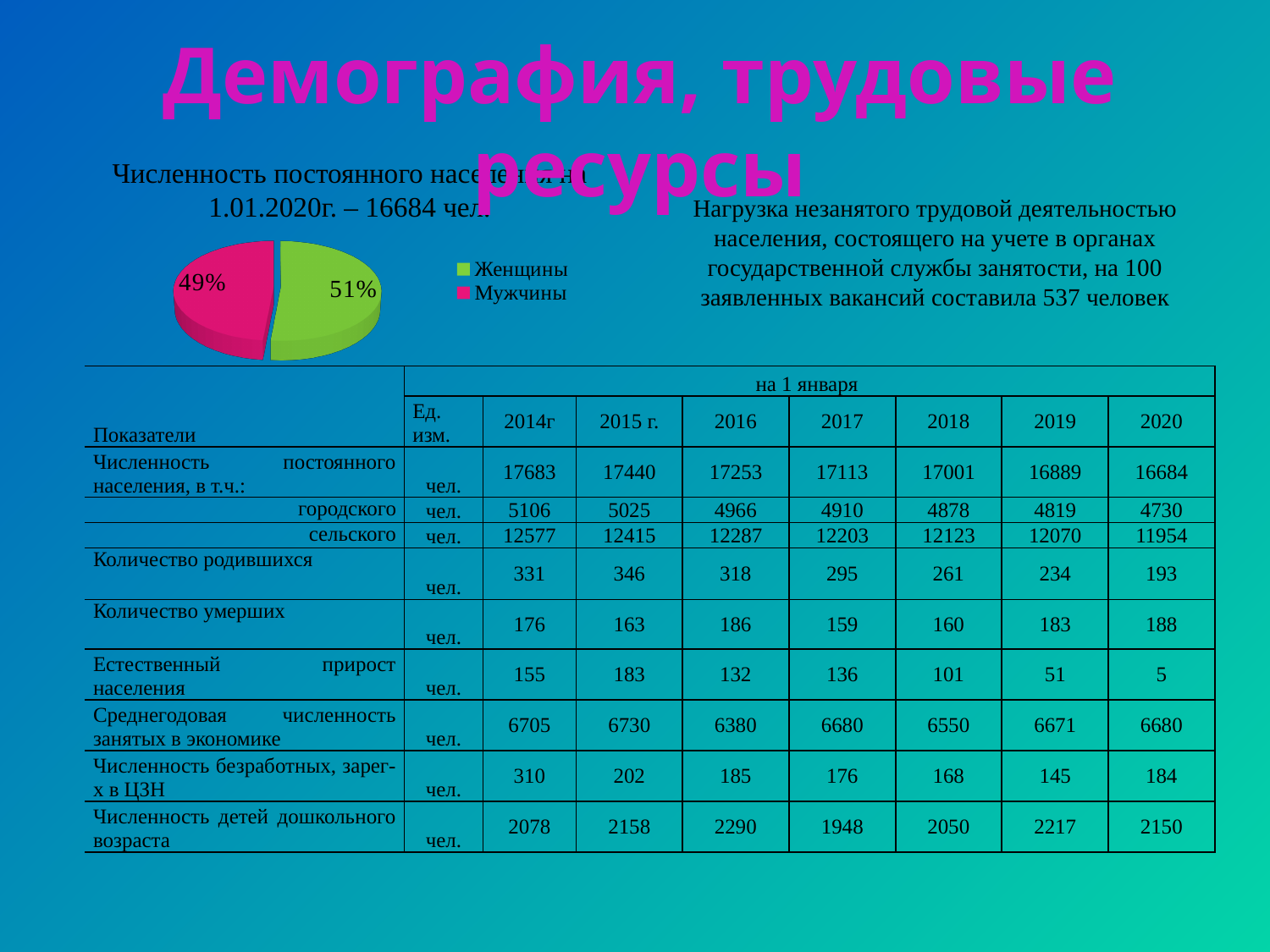
What colour is the Мужчины slice in the pie chart? pink What kind of chart is shown on the slide? pie chart Which slice of the pie chart is the smallest? Мужчины How many slices does the pie chart have? 2 How many entries does the pie chart legend list? 2 Which is larger in the pie chart, Женщины or Мужчины? Женщины What share of the pie chart does Женщины have? 51% What share of the pie chart does Мужчины have? 49% What colour is the Женщины slice in the pie chart? green What is the difference in percentage points between the Женщины and Мужчины slices? 2 Which slice of the pie chart is the largest? Женщины